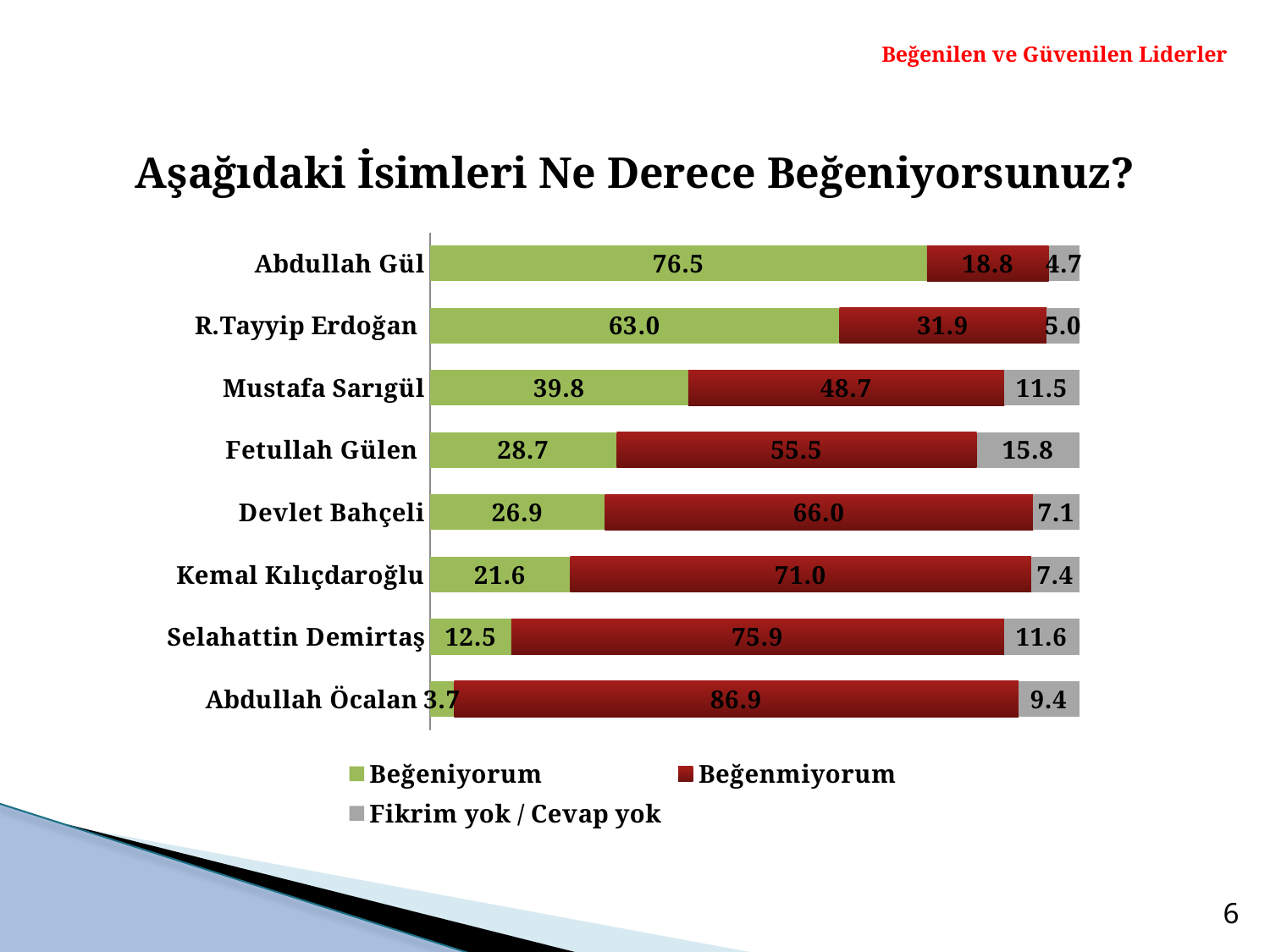
What is the Beğeniyorum value for Abdullah Gül? 76.5 What is the Beğenmiyorum value for Mustafa Sarıgül? 48.7 How many series does the legend list? 3 How many names are shown in the chart? 8 What is the Fikrim yok / Cevap yok value for Fetullah Gülen? 15.8 Which is larger: the Beğenmiyorum value for Kemal Kılıçdaroğlu or for Devlet Bahçeli? Kemal Kılıçdaroğlu Which name has the lowest Beğeniyorum value? Abdullah Öcalan What kind of chart is shown on the slide? Stacked bar chart Which name has the highest Fikrim yok / Cevap yok value? Fetullah Gülen Which name has the highest Beğeniyorum value? Abdullah Gül What is the difference between the Beğeniyorum values for Abdullah Gül and R.Tayyip Erdoğan? 13.5 What is the total of the stacked bar for Selahattin Demirtaş? 100.0